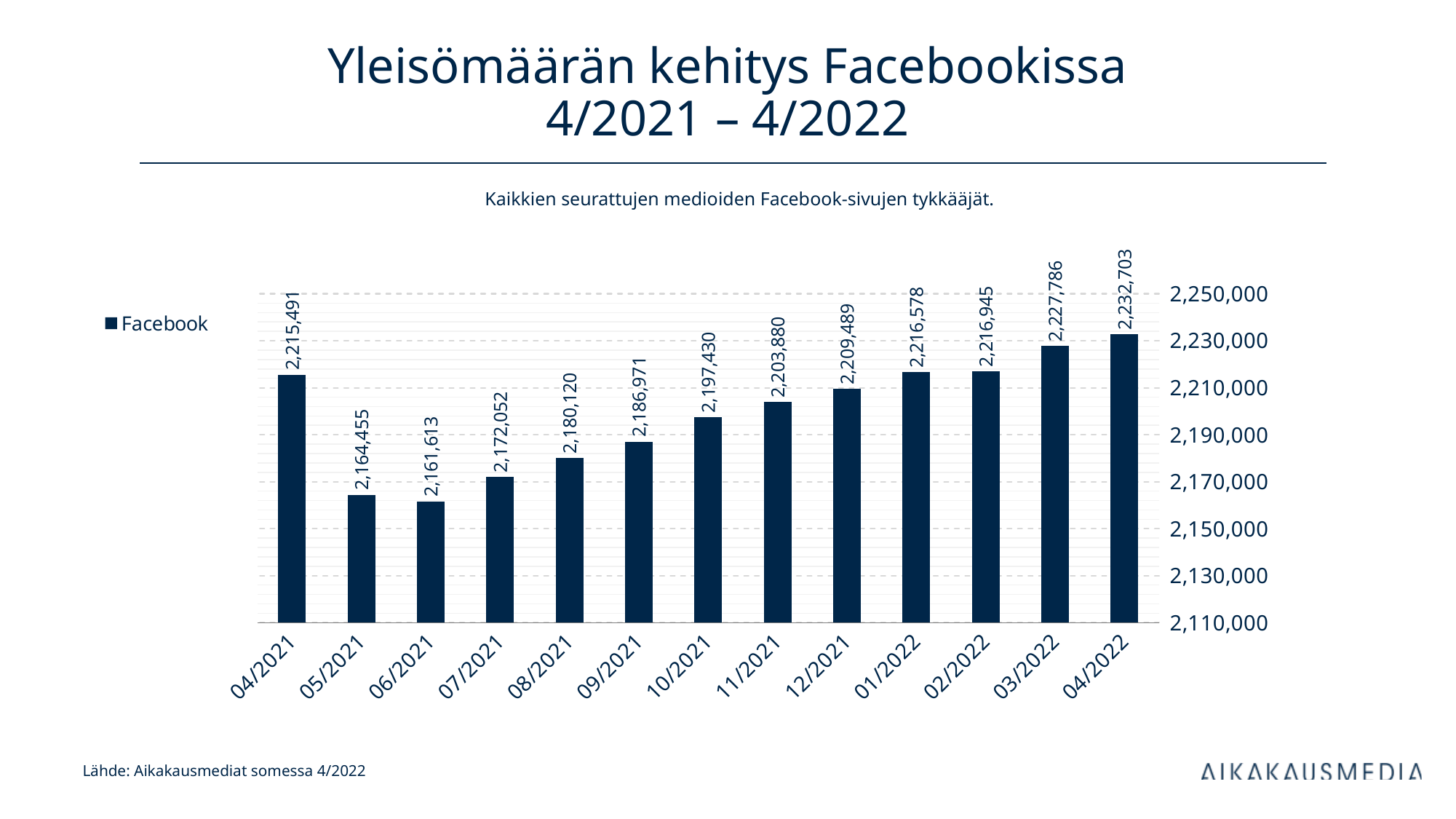
What is the difference between the values for 03/2022 and 02/2022? 10,841 What is the value for 04/2021? 2,215,491 How many months are shown on the x axis? 13 Which is larger, the value for 09/2021 or the value for 11/2021? 11/2021 Do the values rise or fall from 06/2021 to 04/2022? rise Which month has the lowest value? 06/2021 Which month has the highest value? 04/2022 How many series does the legend list? 1 What is the value for 03/2022? 2,227,786 What is the value for 10/2021? 2,197,430 What is the difference between the values for 04/2022 and 04/2021? 17,212 Is the value for 08/2021 greater or less than 2,190,000? less